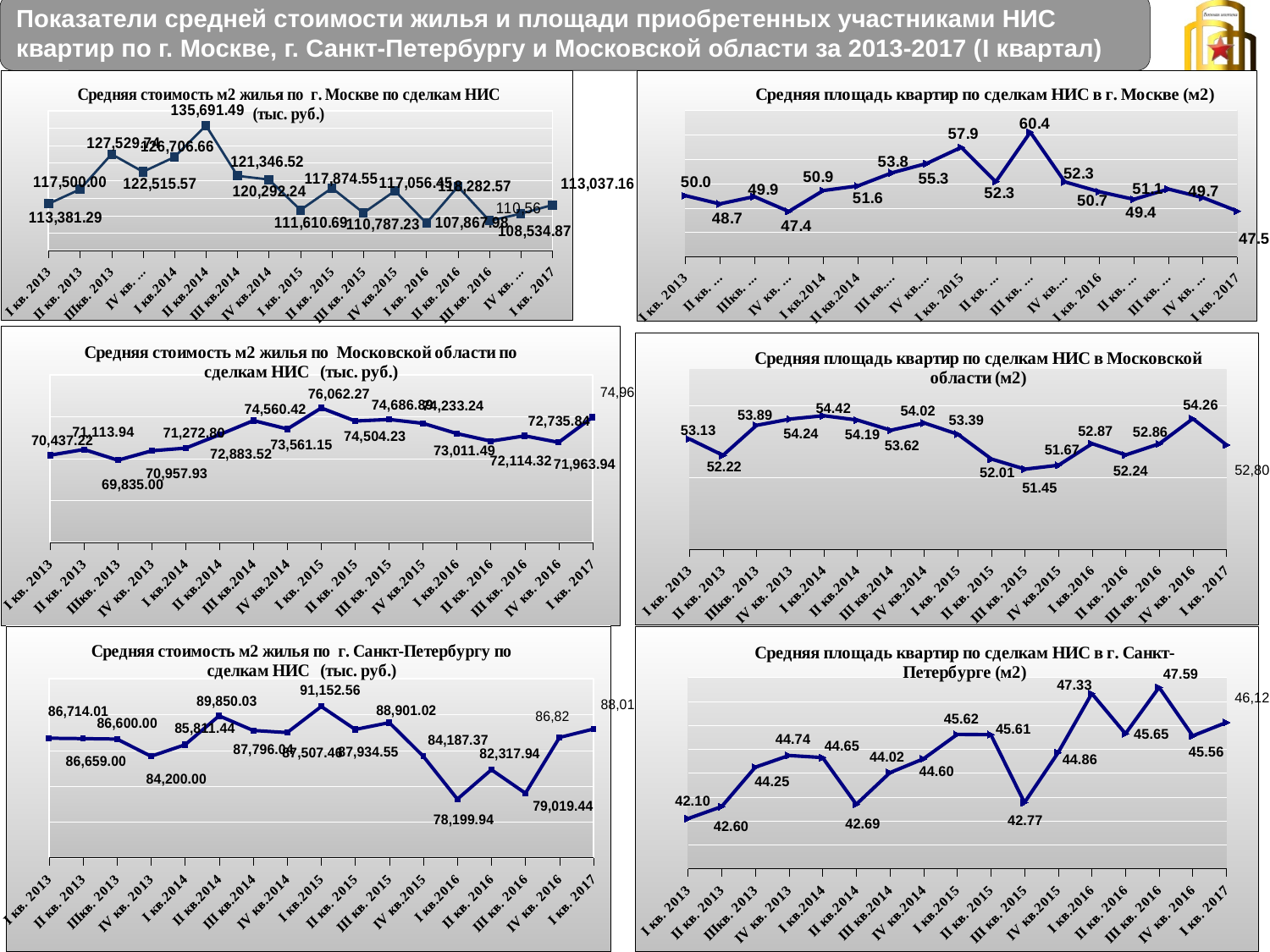
In the chart 'Средняя площадь квартир по сделкам НИС в г. Санкт-Петербурге (м2)', which quarter has the highest value? III кв. 2016 In the chart 'Средняя стоимость м2 жилья по Московской области по сделкам НИС (тыс. руб.)', which quarter has the highest value? I кв. 2015 In the chart 'Средняя стоимость м2 жилья по г. Москве по сделкам НИС (тыс. руб.)', which quarter has the lowest value? I кв. 2016 In the chart 'Средняя стоимость м2 жилья по г. Санкт-Петербургу по сделкам НИС (тыс. руб.)', which is larger: the value for I кв. 2016 or the value for II кв. 2016? II кв. 2016 What kind of chart is 'Средняя площадь квартир по сделкам НИС в г. Санкт-Петербурге (м2)'? Line chart In the chart 'Средняя площадь квартир по сделкам НИС в г. Москве (м2)', what is the value for I кв. 2017? 47.5 In the chart 'Средняя стоимость м2 жилья по г. Санкт-Петербургу по сделкам НИС (тыс. руб.)', what is the value for I кв. 2015? 91,152.56 In the chart 'Средняя площадь квартир по сделкам НИС в г. Москве (м2)', what is the highest value shown? 60.4 In the chart 'Средняя площадь квартир по сделкам НИС в Московской области (м2)', what is the difference between the values for I кв. 2014 (54.42) and III кв. 2015 (51.45)? 2.97 In the chart 'Средняя стоимость м2 жилья по Московской области по сделкам НИС (тыс. руб.)', what is the value for III кв. 2013? 69,835.00 In the chart 'Средняя площадь квартир по сделкам НИС в Московской области (м2)', what is the lowest value shown? 51.45 In the chart 'Средняя стоимость м2 жилья по г. Москве по сделкам НИС (тыс. руб.)', what is the value for II кв. 2014? 135,691.49